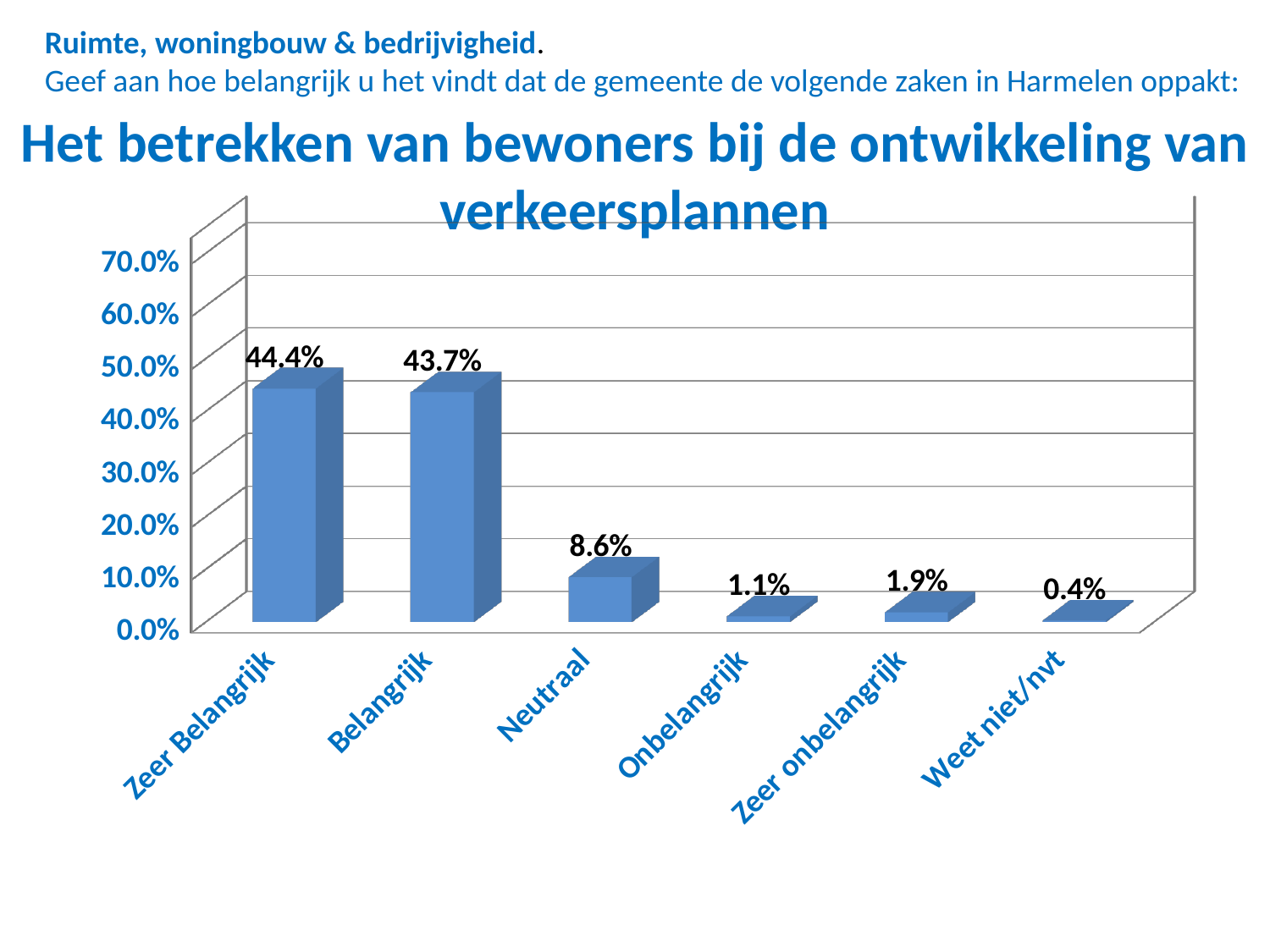
What is the difference between Zeer Belangrijk and Belangrijk? 0.7% What kind of chart is shown on the slide? bar chart Which category has the lowest value? Weet niet/nvt What is the value for Belangrijk? 43.7% What is the difference between Neutraal and Onbelangrijk? 7.5% What is the value for Weet niet/nvt? 0.4% Which is larger, Onbelangrijk or Zeer onbelangrijk? Zeer onbelangrijk What is the value for Neutraal? 8.6% Is the value for Neutraal greater or less than 10.0%? less How many categories are shown on the x axis? 6 What is the value for Zeer Belangrijk? 44.4% Which category has the highest value? Zeer Belangrijk